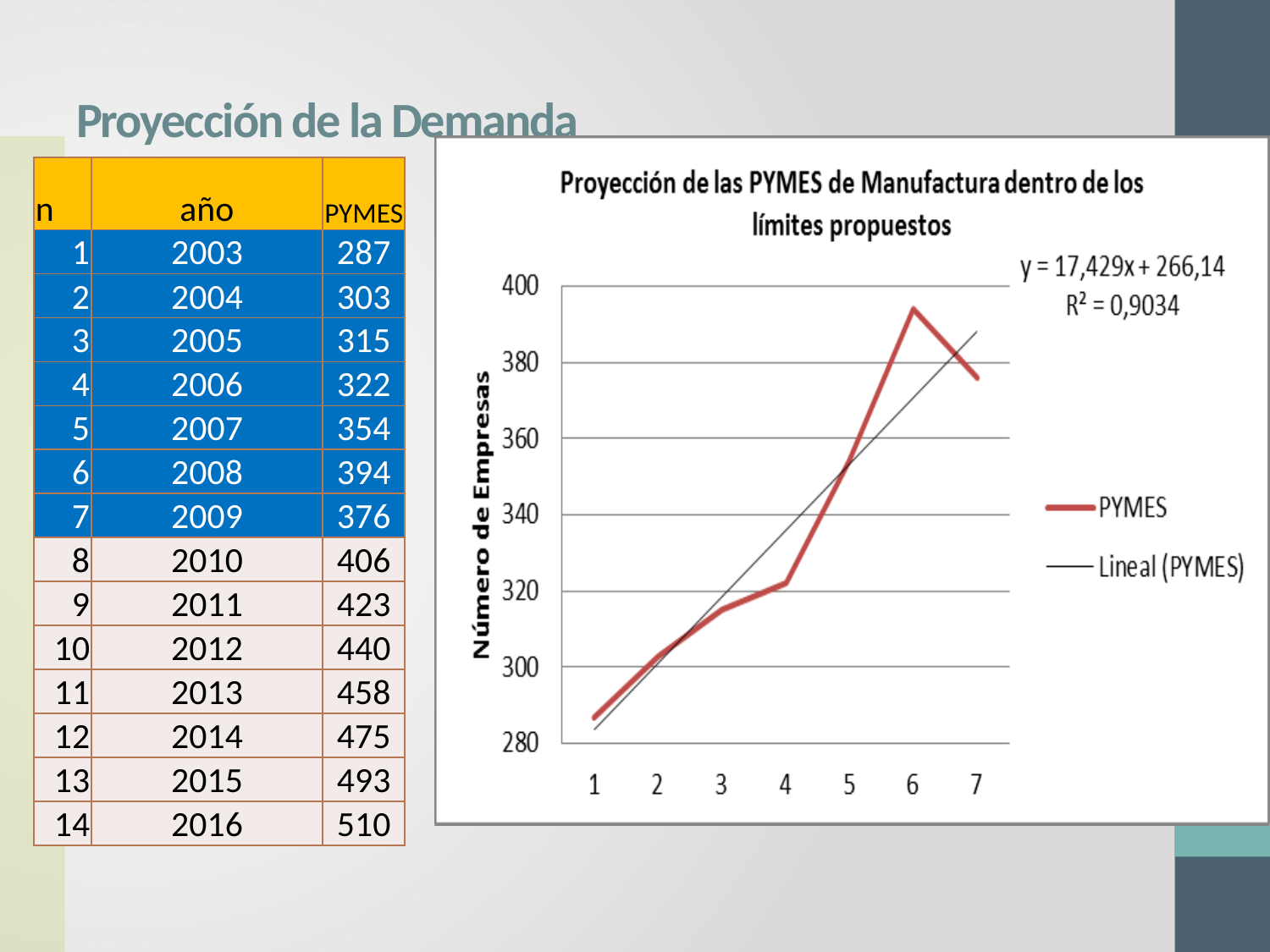
What kind of chart is shown on the slide? line chart At which x-axis point does the PYMES line reach its highest value? 6 At which x-axis point does the PYMES line have its lowest value? 1 Which has the larger PYMES value, point 6 or point 7? point 6 How many points are plotted along the x axis of the chart? 7 What is the title of the chart's vertical axis? Número de Empresas What is the difference between the PYMES values at point 6 and point 7? 18 Does the PYMES line rise or fall between point 6 and point 7? fall Is the PYMES value at point 4 greater or less than 340? less Is the PYMES value at point 6 greater or less than 380? greater How many series does the chart legend list? 2 What is the PYMES value plotted at point 6 (n = 6, year 2008)? 394